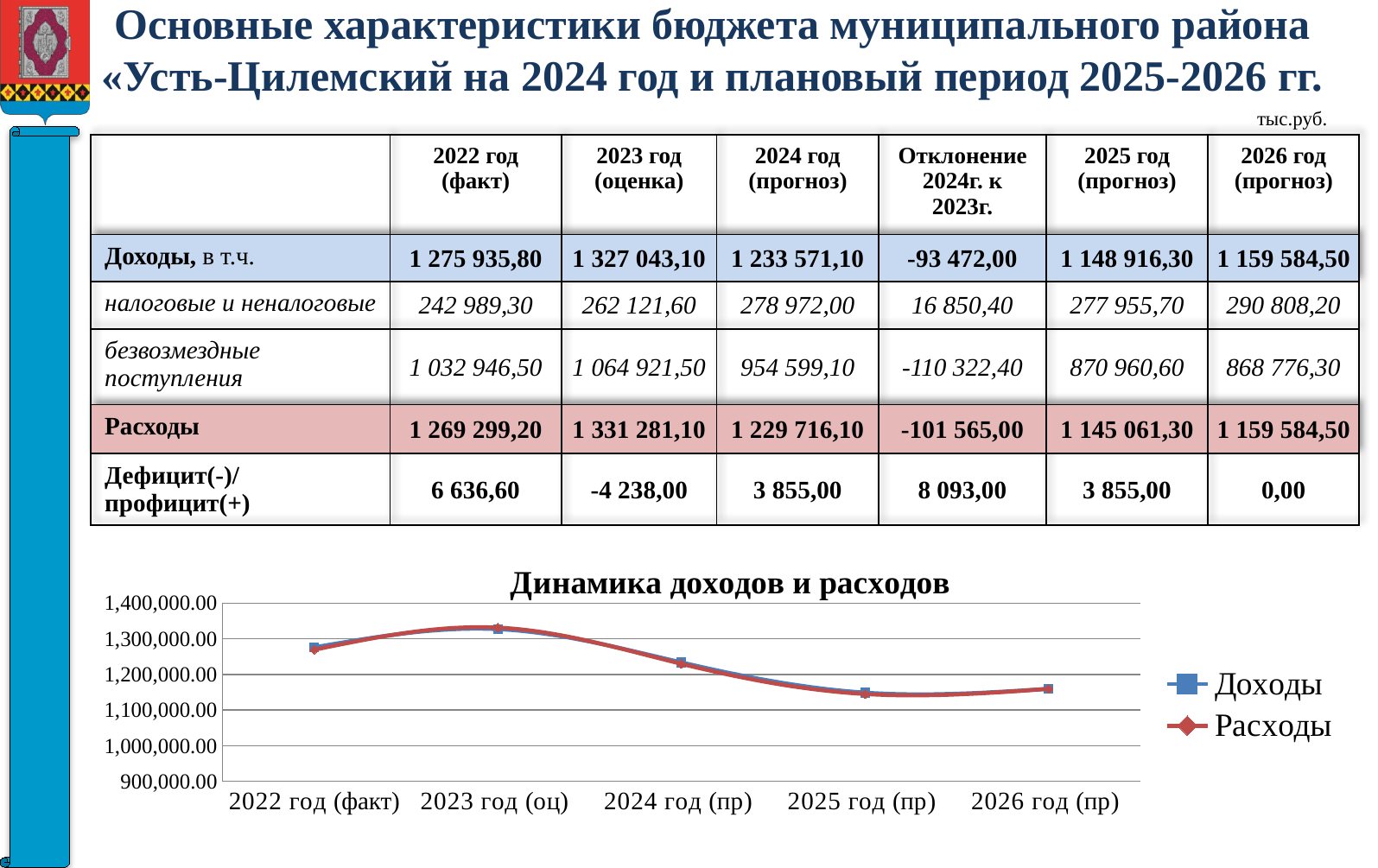
What is the title of the chart on the slide? Динамика доходов и расходов What kind of chart is "Динамика доходов и расходов"? line chart In the chart "Динамика доходов и расходов", is the value of Доходы for 2023 год (оц) greater or less than 1,300,000.00? greater In the chart "Динамика доходов и расходов", is the value of Доходы for 2022 год (факт) greater or less than 1,200,000.00? greater How many points along the x axis does the chart "Динамика доходов и расходов" have? 5 In the chart "Динамика доходов и расходов", at which x-axis category is Доходы highest? 2023 год (оц) In the chart "Динамика доходов и расходов", at which x-axis category is Расходы lowest? 2025 год (пр) In the chart "Динамика доходов и расходов", is the value of Расходы for 2025 год (пр) greater or less than 1,200,000.00? less According to the table, what is the value of Доходы for 2023 год (оценка)? 1 327 043,10 According to the table, what is the value of Расходы for 2025 год (прогноз)? 1 145 061,30 How many series does the legend of the chart "Динамика доходов и расходов" list? 2 In the chart "Динамика доходов и расходов", do the Доходы values rise or fall from 2023 год (оц) to 2025 год (пр)? fall